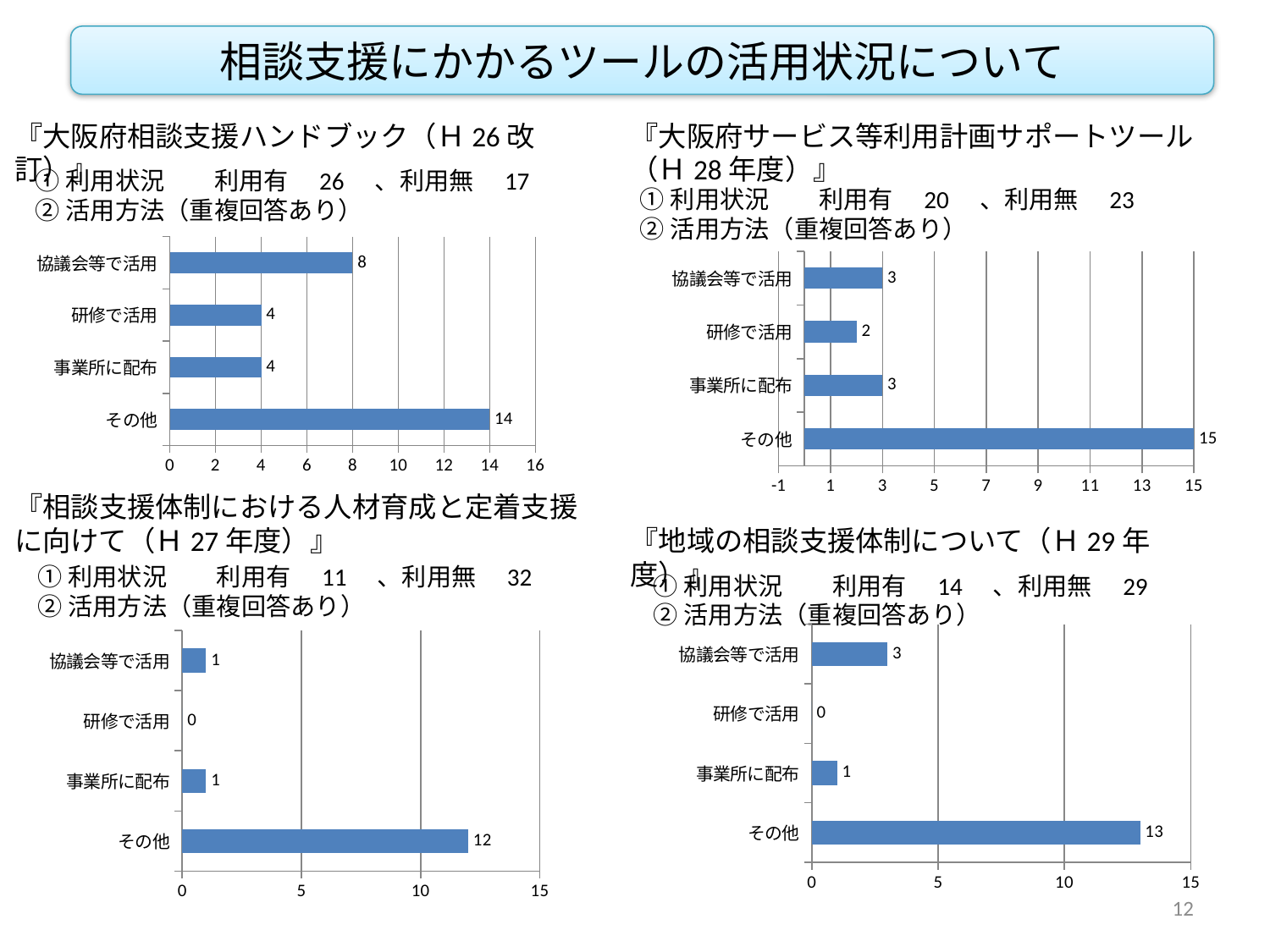
In the top-left chart (大阪府相談支援ハンドブック), what is the difference between その他 and 協議会等で活用? 6 In the bottom-right chart (地域の相談支援体制について), which is larger, 事業所に配布 or 協議会等で活用? 協議会等で活用 What type of chart is the top-left chart (大阪府相談支援ハンドブック)? Bar chart How many categories are shown in the bottom-right chart (地域の相談支援体制について)? 4 In the top-right chart (大阪府サービス等利用計画サポートツール), what is the value for 研修で活用? 2 In the top-right chart (大阪府サービス等利用計画サポートツール), what is the value for その他? 15 In the bottom-left chart (相談支援体制における人材育成と定着支援に向けて), what is the value for 研修で活用? 0 In the top-left chart (大阪府相談支援ハンドブック), what is the value for 協議会等で活用? 8 In the top-right chart (大阪府サービス等利用計画サポートツール), which category has the lowest value? 研修で活用 In the bottom-right chart (地域の相談支援体制について), what is the value for 協議会等で活用? 3 In the bottom-left chart (相談支援体制における人材育成と定着支援に向けて), what is the value for その他? 12 In the top-left chart (大阪府相談支援ハンドブック), which category has the highest value? その他